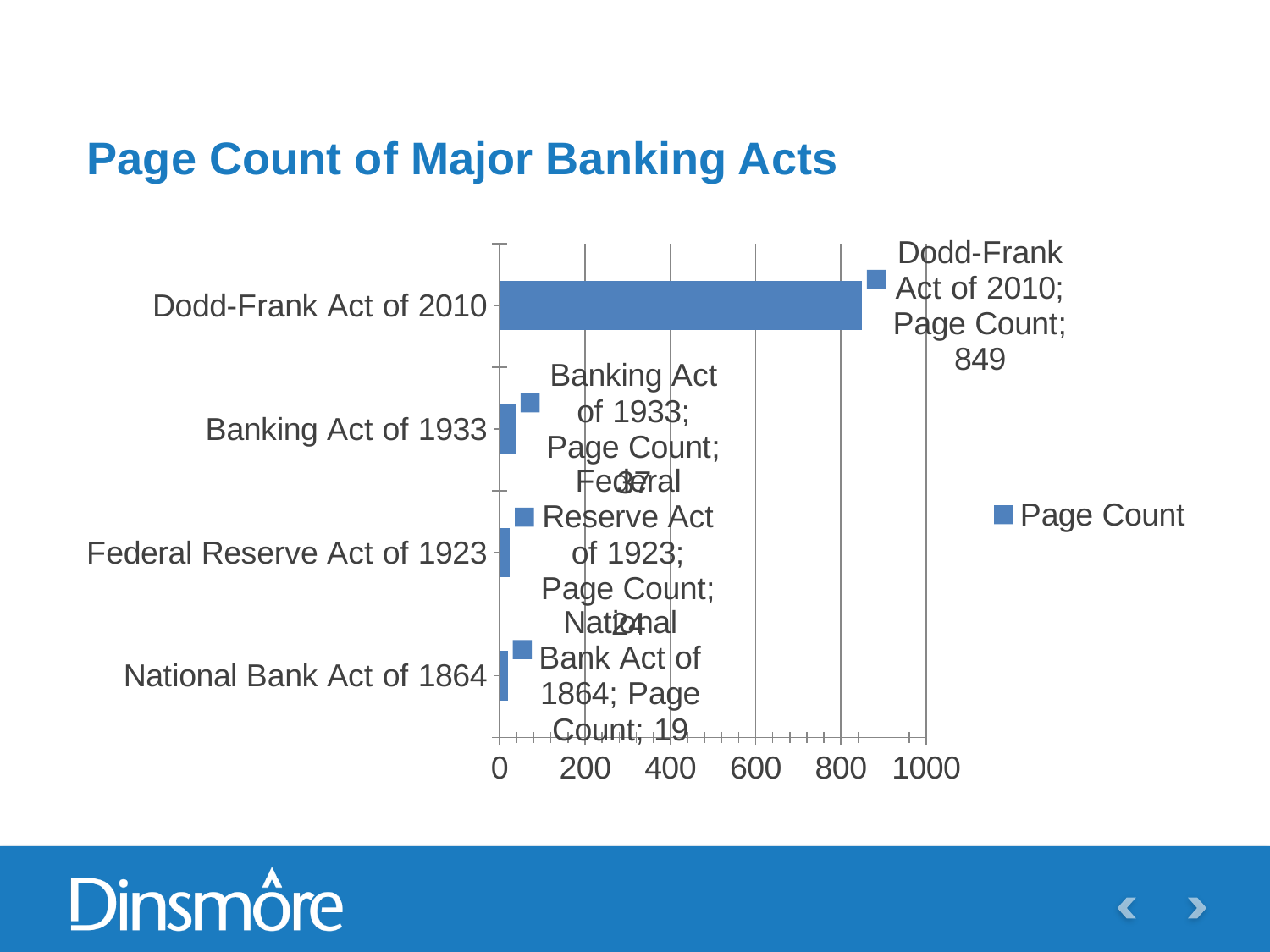
How many series does the legend list? 1 How many pages more does the Dodd-Frank Act of 2010 have than the National Bank Act of 1864? 830 What is the title of the chart? Page Count of Major Banking Acts What is the page count for the Federal Reserve Act of 1923? 24 What is the page count for the National Bank Act of 1864? 19 What type of chart is shown on the slide? Bar chart How many acts are shown in the chart? 4 Which act has the highest page count? Dodd-Frank Act of 2010 What is the page count for the Banking Act of 1933? 37 Which act has the lowest page count? National Bank Act of 1864 Is the page count for the Dodd-Frank Act of 2010 greater or less than 800? greater What is the page count for the Dodd-Frank Act of 2010? 849